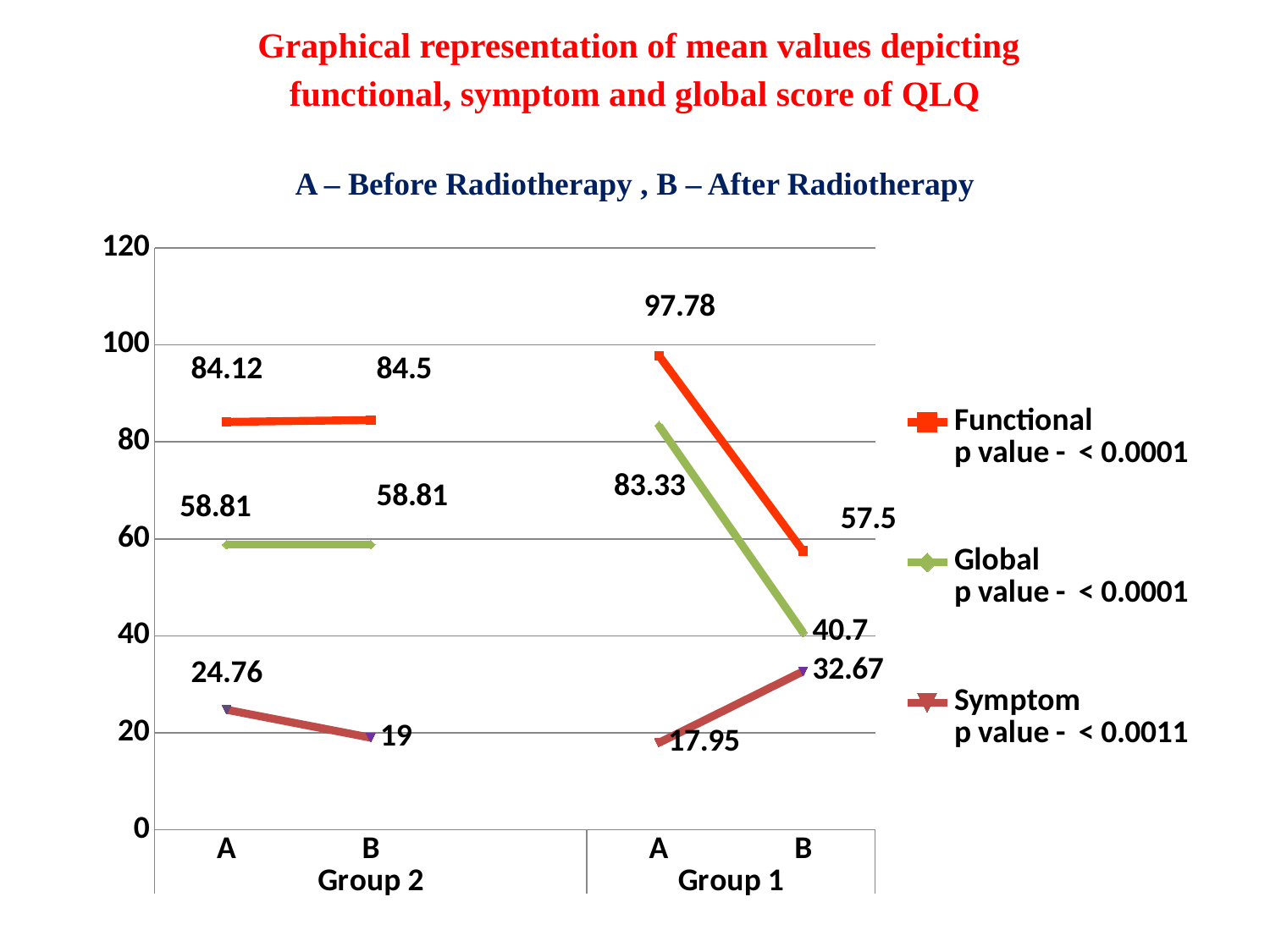
What is the Global value for Group 1 at B (after radiotherapy)? 40.7 What is the Functional value for Group 1 at A (before radiotherapy)? 97.78 Which is larger for Group 2 at B: the Global value or the Symptom value? Global What kind of chart is shown on the slide? line chart What is the Functional value for Group 2 at B (after radiotherapy)? 84.5 How many series does the legend list? 3 Does the Symptom series rise or fall from A to B in Group 1? rise What p value is shown in the legend for the Symptom series? < 0.0011 Which point has the highest Functional value? Group 1 A Which point has the lowest Symptom value? Group 1 A What is the difference between the Functional values for Group 1 at A and at B? 40.28 What is the Symptom value for Group 2 at A (before radiotherapy)? 24.76